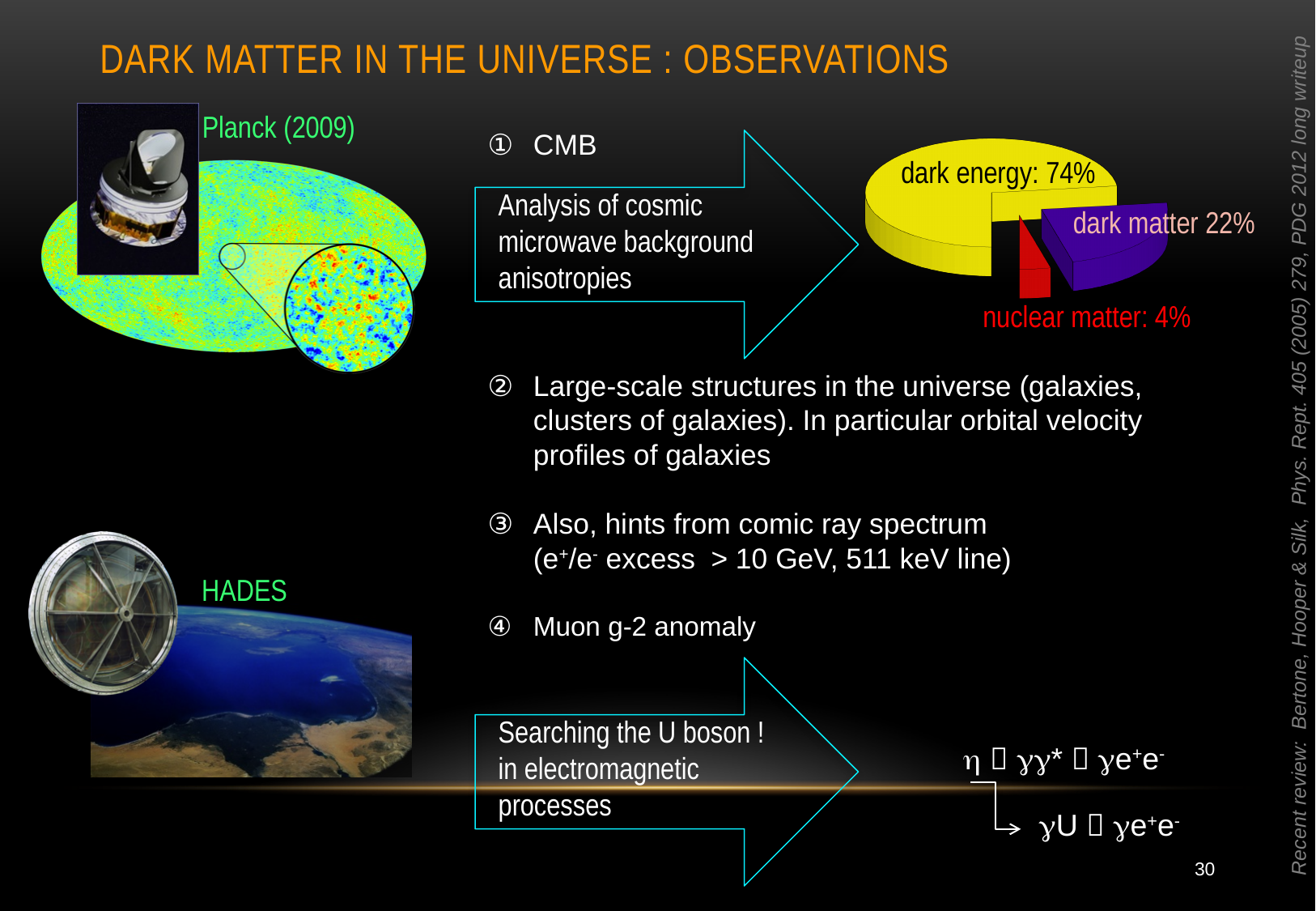
What kind of chart is shown on the slide? pie chart What share of the pie chart is dark energy? 74% What is the difference between the dark matter and nuclear matter shares in the pie chart? 18% What colour is the dark energy slice in the pie chart? yellow What share of the pie chart is nuclear matter? 4% Which slice of the pie chart is the smallest? nuclear matter What share of the pie chart is dark matter? 22% Which is larger in the pie chart, dark matter or nuclear matter? dark matter What colour is the nuclear matter slice in the pie chart? red Which slice of the pie chart is the largest? dark energy What is the difference between the dark energy and dark matter shares in the pie chart? 52% How many slices does the pie chart have? 3